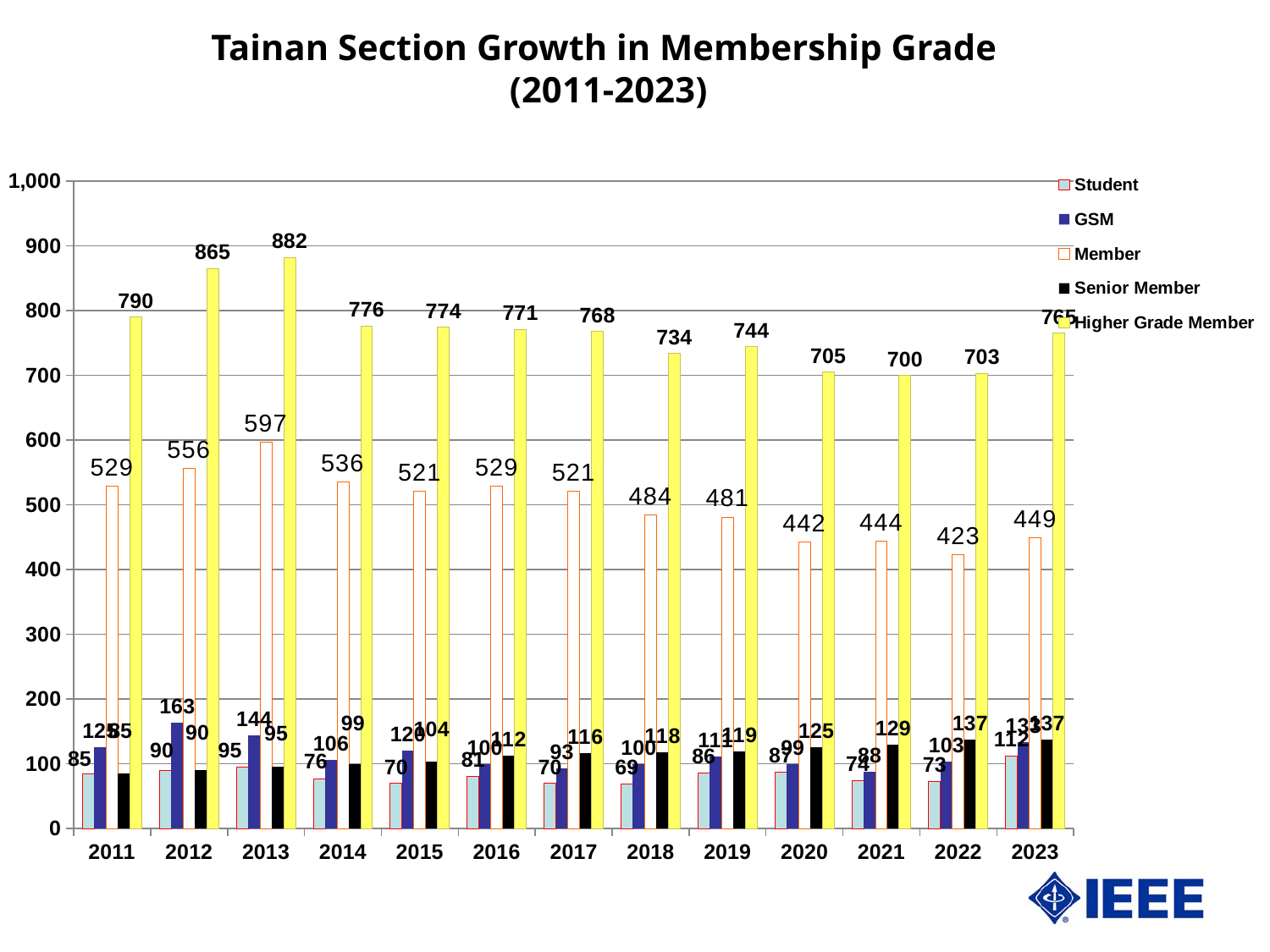
In which year is the Higher Grade Member value highest? 2013 What is the Higher Grade Member value for 2013? 882 In which year is the Member value lowest? 2022 How many series does the legend list? 5 Does the Member value rise or fall from 2013 to 2022? fall Is the Higher Grade Member value for 2020 greater or less than 800? less What is the difference between the Higher Grade Member values for 2012 and 2011? 75 What is the Member value for 2011? 529 How many years are shown on the x axis? 13 Which year has the larger Member value, 2013 or 2014? 2013 What kind of chart is shown on the slide? bar chart What is the Student value for 2023? 112